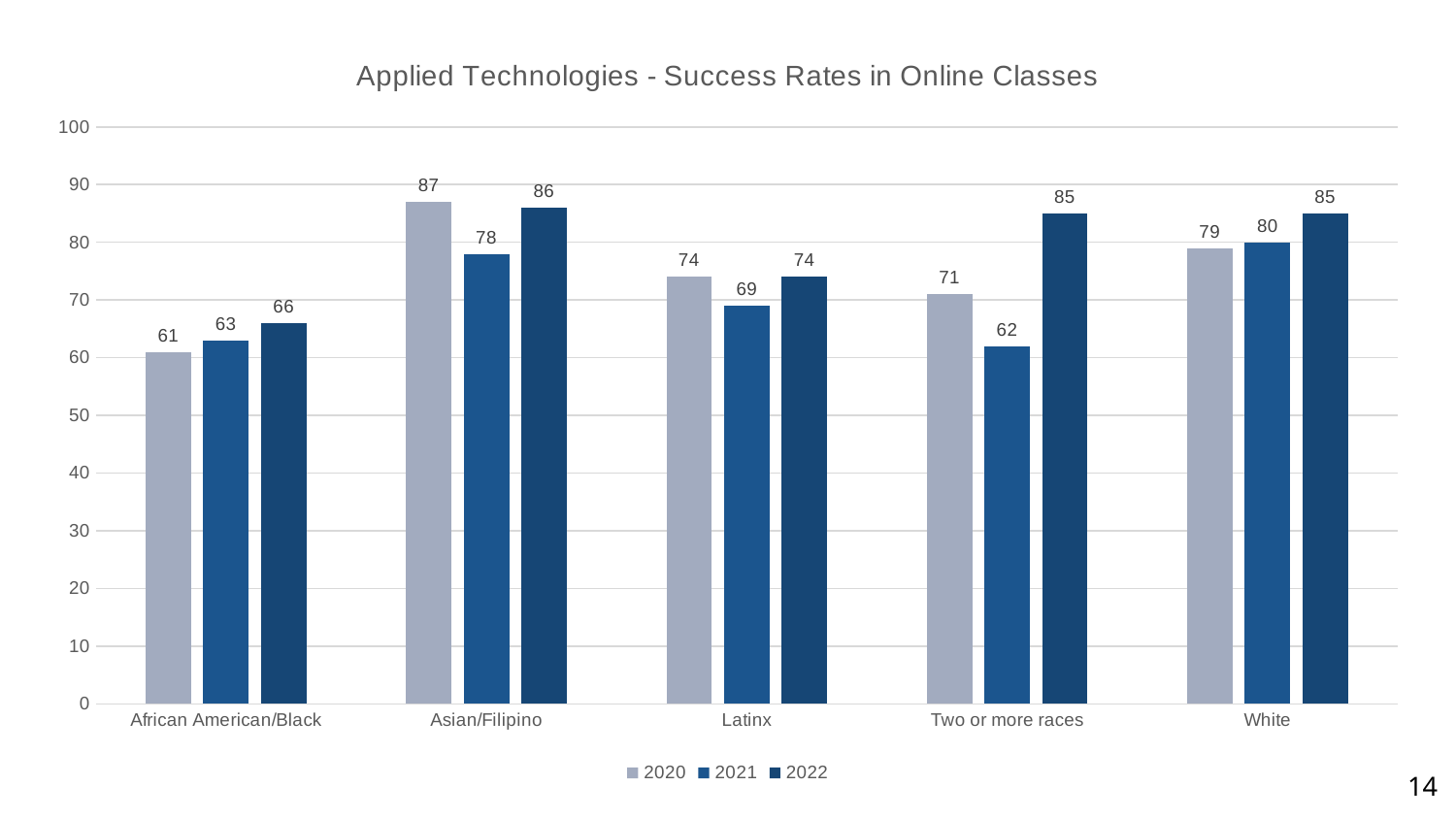
Which is larger, the 2021 success rate for White students or the 2021 success rate for Asian/Filipino students? White How many series does the legend list? 3 What kind of chart is shown on the slide? Bar chart What is the 2020 success rate for Asian/Filipino students? 87 Which category has the highest 2020 success rate? Asian/Filipino What is the 2021 success rate for Two or more races? 62 What is the 2022 success rate for Latinx students? 74 Which category has the lowest 2022 success rate? African American/Black What is the title of the chart? Applied Technologies - Success Rates in Online Classes What is the difference between the 2022 and 2021 success rates for Two or more races? 23 Do the success rates for African American/Black students rise or fall from 2020 to 2022? Rise How many categories are shown on the x axis? 5